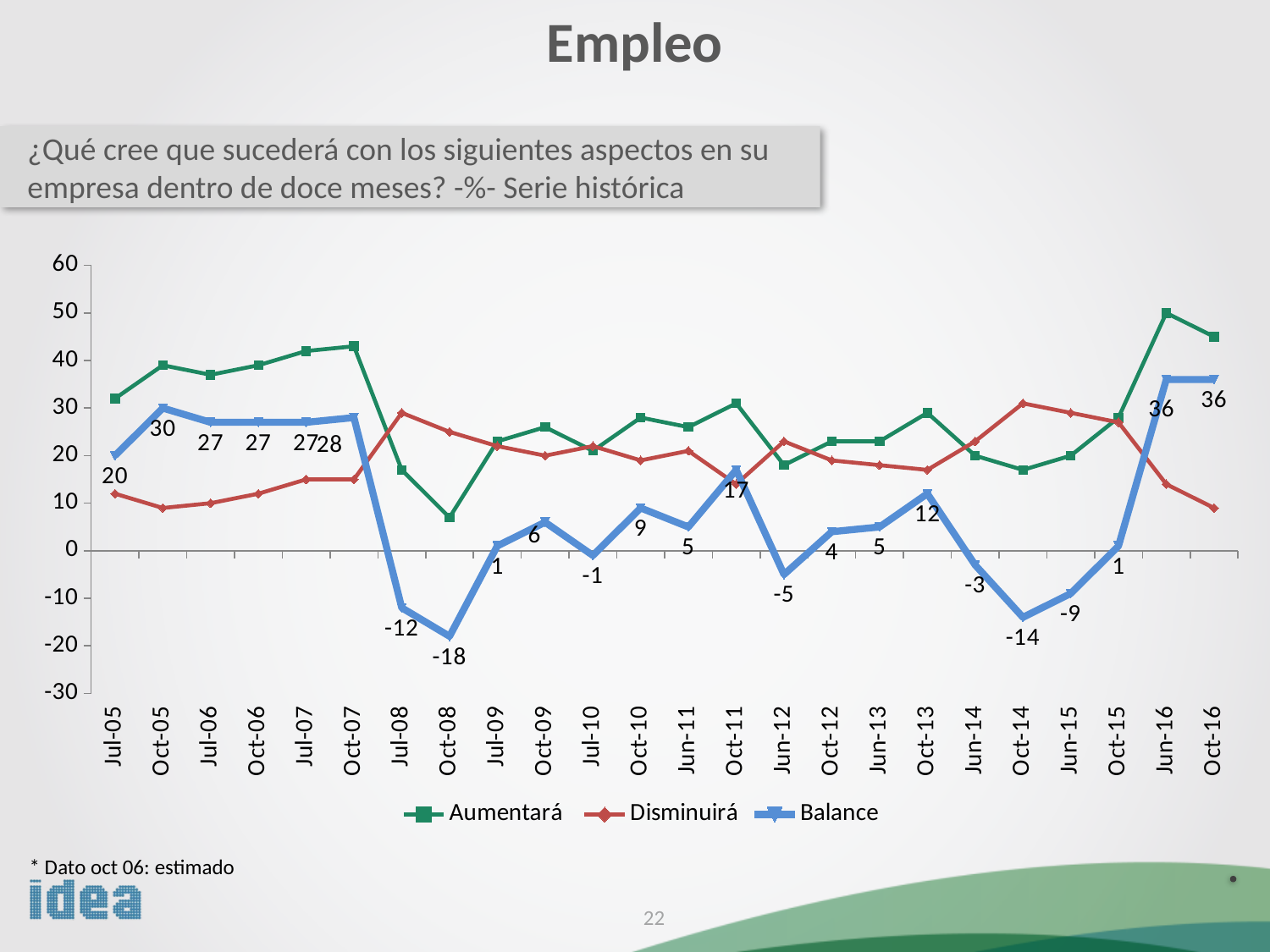
What kind of chart is shown on the slide? line chart How many series does the legend list? 3 What is the Balance value for Oct-08? -18 Is the value of Aumentará for Jun-16 greater or less than 40? greater What is the Balance value for Jun-16? 36 Is the value of Disminuirá for Oct-05 greater or less than 20? less Is the value of Aumentará for Oct-08 greater or less than 10? less At which date does the Balance series reach its lowest value? Oct-08 What is the difference between the Balance values for Oct-05 and Jul-05? 10 What is the Balance value for Oct-11? 17 How many dates are shown on the x axis? 24 Which is larger, the Balance value for Oct-11 or for Oct-13? Oct-11